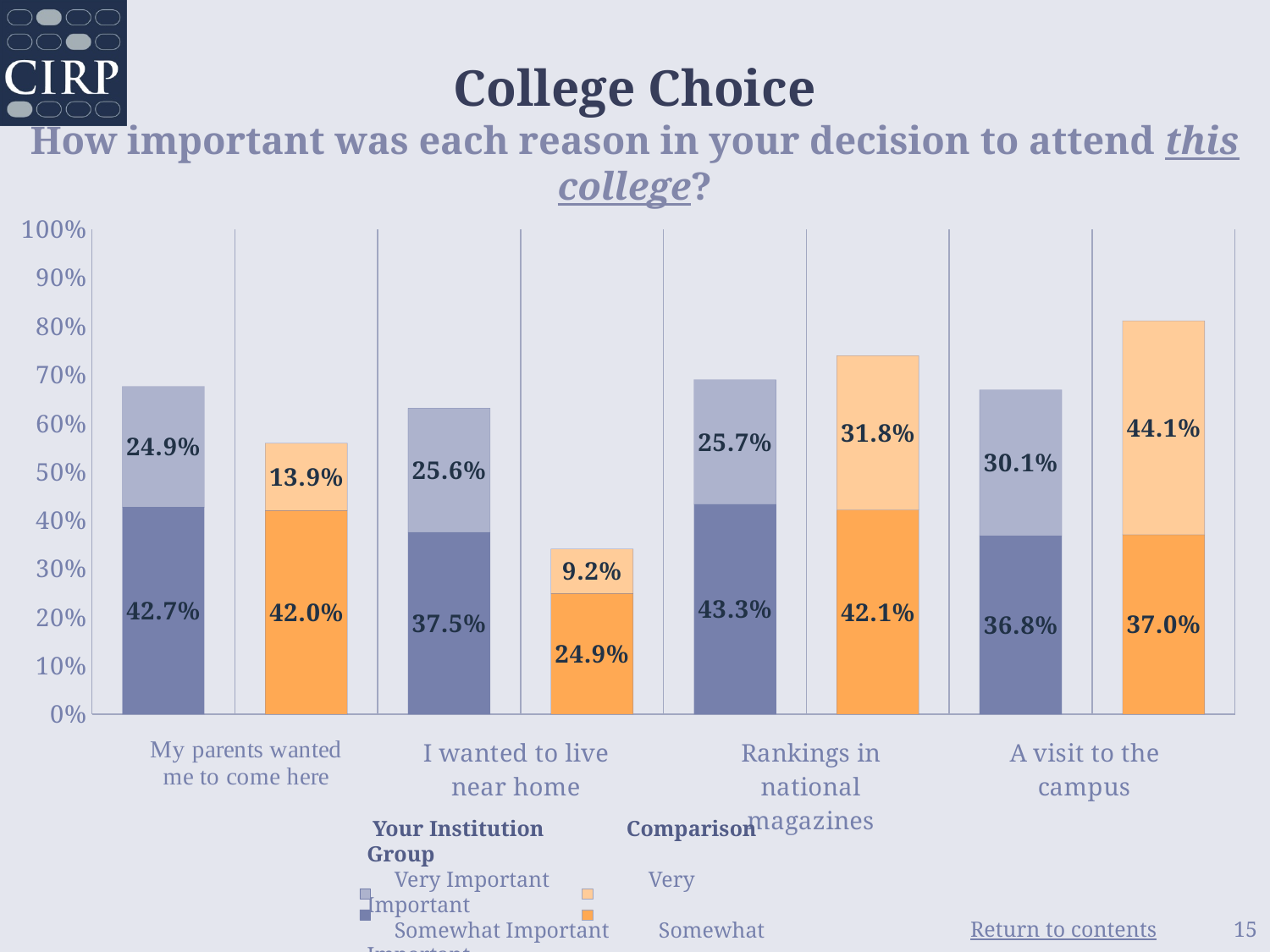
What percentage of the Comparison Group rated "Rankings in national magazines" as Very Important? 31.8% Which reason has the lowest Very Important percentage for the Comparison Group? I wanted to live near home How many reasons (categories) are shown on the x axis? 4 For "A visit to the campus", which group has the larger Very Important percentage, Your Institution or the Comparison Group? Comparison Group Is the total height of the Comparison Group bar for "A visit to the campus" greater or less than 80%? greater What is the total of the Your Institution stacked bar for "Rankings in national magazines"? 69.0% What type of chart is shown on the slide? Stacked bar chart Which reason has the highest Very Important percentage for the Comparison Group? A visit to the campus What percentage of Your Institution students rated "A visit to the campus" as Very Important? 30.1% What is the difference between the Your Institution and Comparison Group Very Important percentages for "My parents wanted me to come here"? 11.0% What percentage of the Comparison Group rated "I wanted to live near home" as Somewhat Important? 24.9% How many series does the legend list? 4